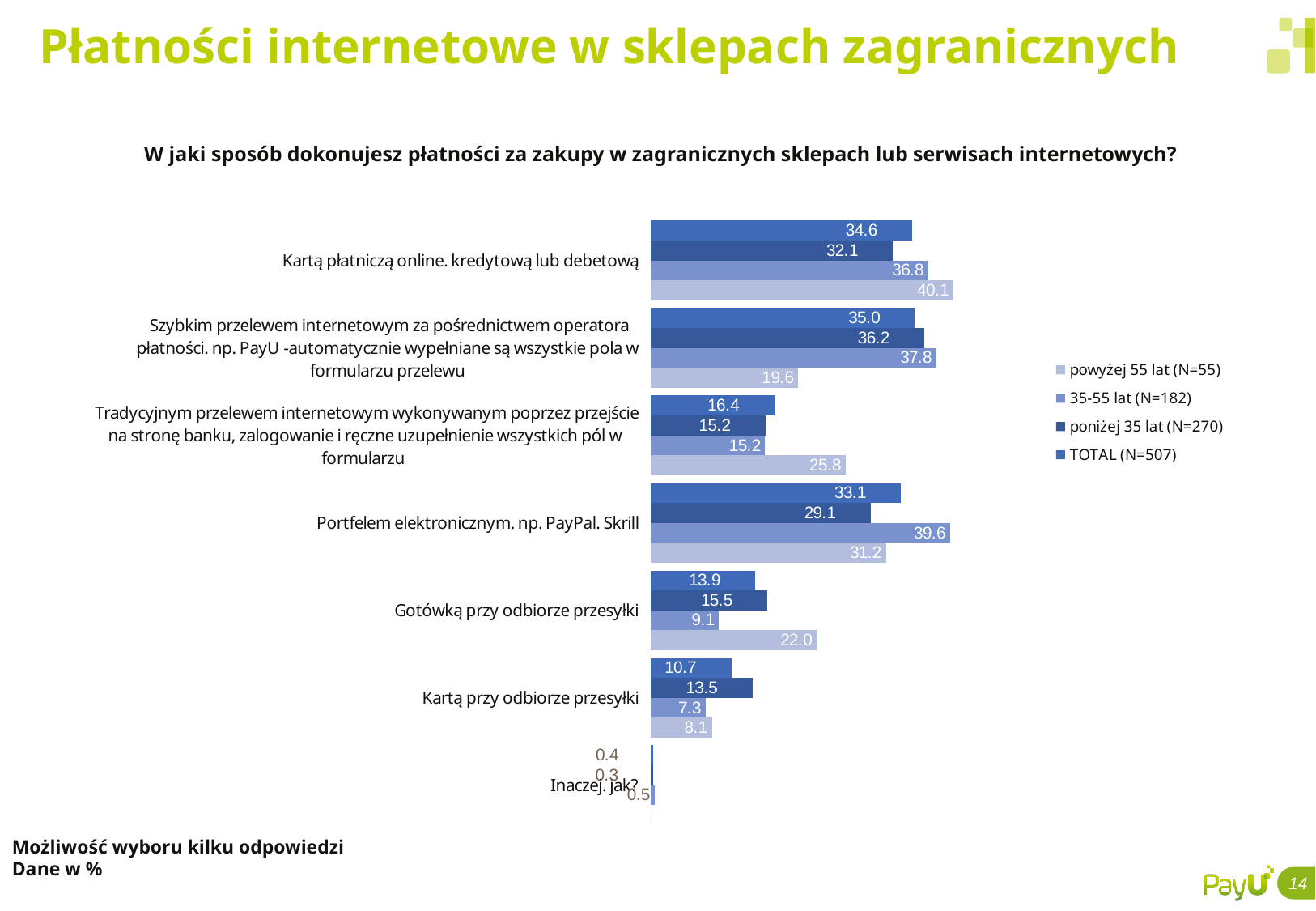
What is the sample size (N) for the "35-55 lat" series in the legend? 182 What is the difference between the "powyżej 55 lat (N=55)" and "poniżej 35 lat (N=270)" values for "Kartą płatniczą online. kredytową lub debetową"? 8.0 What is the value for "poniżej 35 lat (N=270)" for "Gotówką przy odbiorze przesyłki"? 15.5 What is the TOTAL (N=507) value for "Kartą płatniczą online. kredytową lub debetową"? 34.6 Which category has the highest TOTAL (N=507) value? Szybkim przelewem internetowym za pośrednictwem operatora płatności What is the value for "35-55 lat (N=182)" for "Portfelem elektronicznym. np. PayPal. Skrill"? 39.6 For "Tradycyjnym przelewem internetowym", which is larger: the TOTAL (N=507) value or the "powyżej 55 lat (N=55)" value? powyżej 55 lat (N=55) What is the value for "powyżej 55 lat (N=55)" for "Szybkim przelewem internetowym za pośrednictwem operatora płatności"? 19.6 What kind of chart is shown on the slide? Bar chart How many categories are shown on the chart? 7 How many series does the legend list? 4 Which category has the lowest value for "powyżej 55 lat (N=55)"? Inaczej. jak?